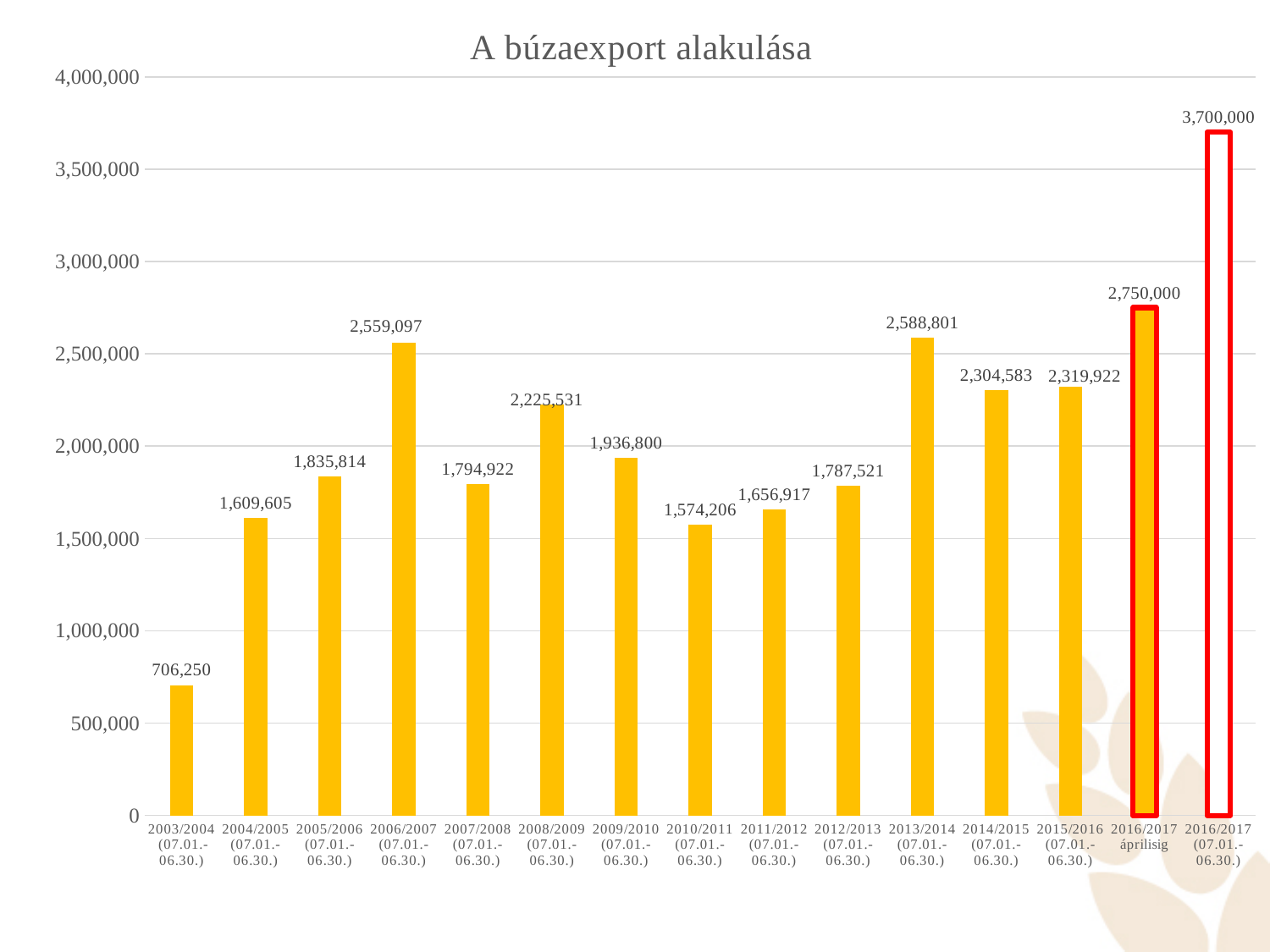
What is the value for 2013/2014 (07.01.-06.30.)? 2,588,801 Which category has the lowest value? 2003/2004 (07.01.-06.30.) Do the values rise or fall from 2010/2011 to 2013/2014? rise How many categories (seasons) are plotted on the x axis? 15 Which category has the highest value? 2016/2017 (07.01.-06.30.) Is the value for 2009/2010 (07.01.-06.30.) greater or less than 2,000,000? less What is the value for 2003/2004 (07.01.-06.30.)? 706,250 What kind of chart is shown on the slide? bar chart What is the value for 2016/2017 áprilisig? 2,750,000 Which is larger, the value for 2008/2009 (07.01.-06.30.) or the value for 2009/2010 (07.01.-06.30.)? 2008/2009 (07.01.-06.30.) What is the difference between the value for 2016/2017 (07.01.-06.30.) and the value for 2016/2017 áprilisig? 950,000 What is the title of the chart? A búzaexport alakulása